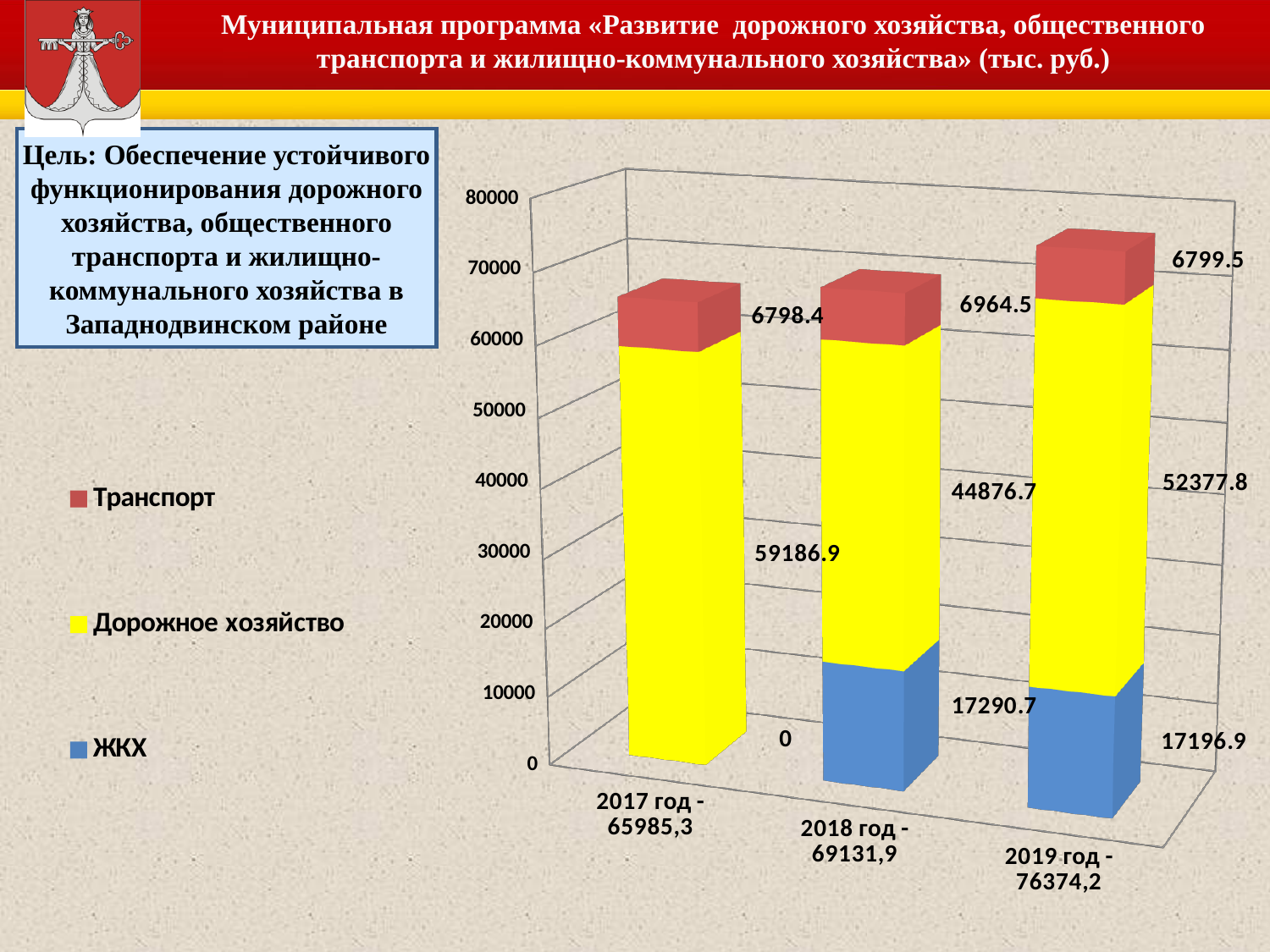
In which year is Дорожное хозяйство lowest? 2018 год In which year is Дорожное хозяйство highest? 2017 год What is the value of Транспорт for 2019 год? 6799.5 What is the difference between Дорожное хозяйство in 2017 год and in 2019 год? 6809.1 What kind of chart is shown on the slide? Stacked bar chart What is the value of Дорожное хозяйство for 2017 год? 59186.9 How many years (categories) are shown on the x axis? 3 What is the value of ЖКХ for 2018 год? 17290.7 What is the total of the stacked bar for 2018 год? 69131,9 How many series does the legend list? 3 What is the value of ЖКХ for 2017 год? 0 Which is larger: Дорожное хозяйство in 2019 год or in 2018 год? 2019 год